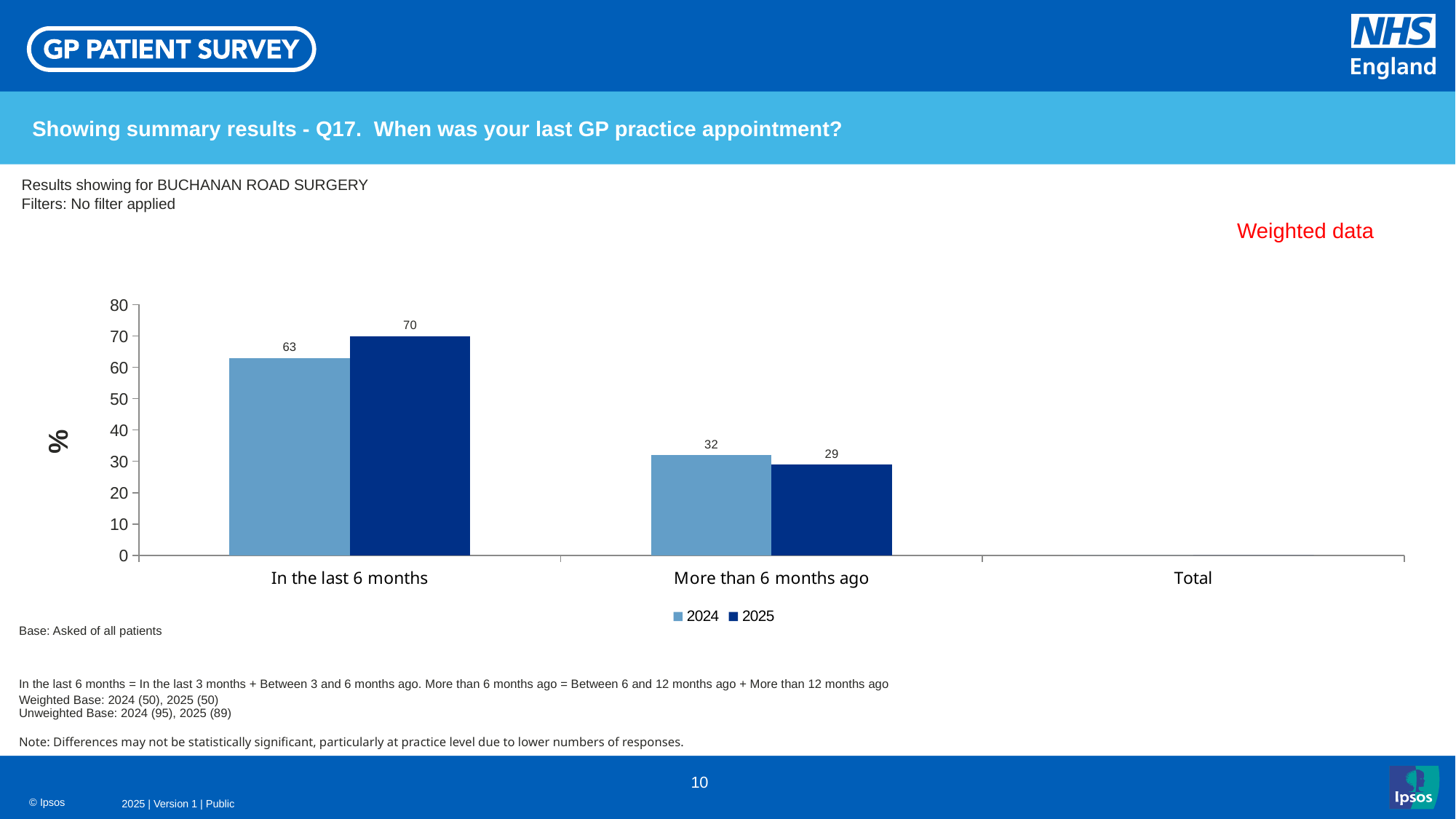
How many series does the legend list? 2 Which category has the highest 2025 value? In the last 6 months What kind of chart is shown on the slide? Bar chart What is the 2025 value for 'More than 6 months ago'? 29 What is the label on the vertical axis of the chart? % What is the 2024 value for 'More than 6 months ago'? 32 What is the difference between the 2025 and 2024 values for 'In the last 6 months'? 7 What is the 2024 value for 'In the last 6 months'? 63 What is the difference between the 2024 and 2025 values for 'More than 6 months ago'? 3 Which category has the lowest 2024 value? More than 6 months ago What is the 2025 value for 'In the last 6 months'? 70 For 'More than 6 months ago', which year has the larger value, 2024 or 2025? 2024